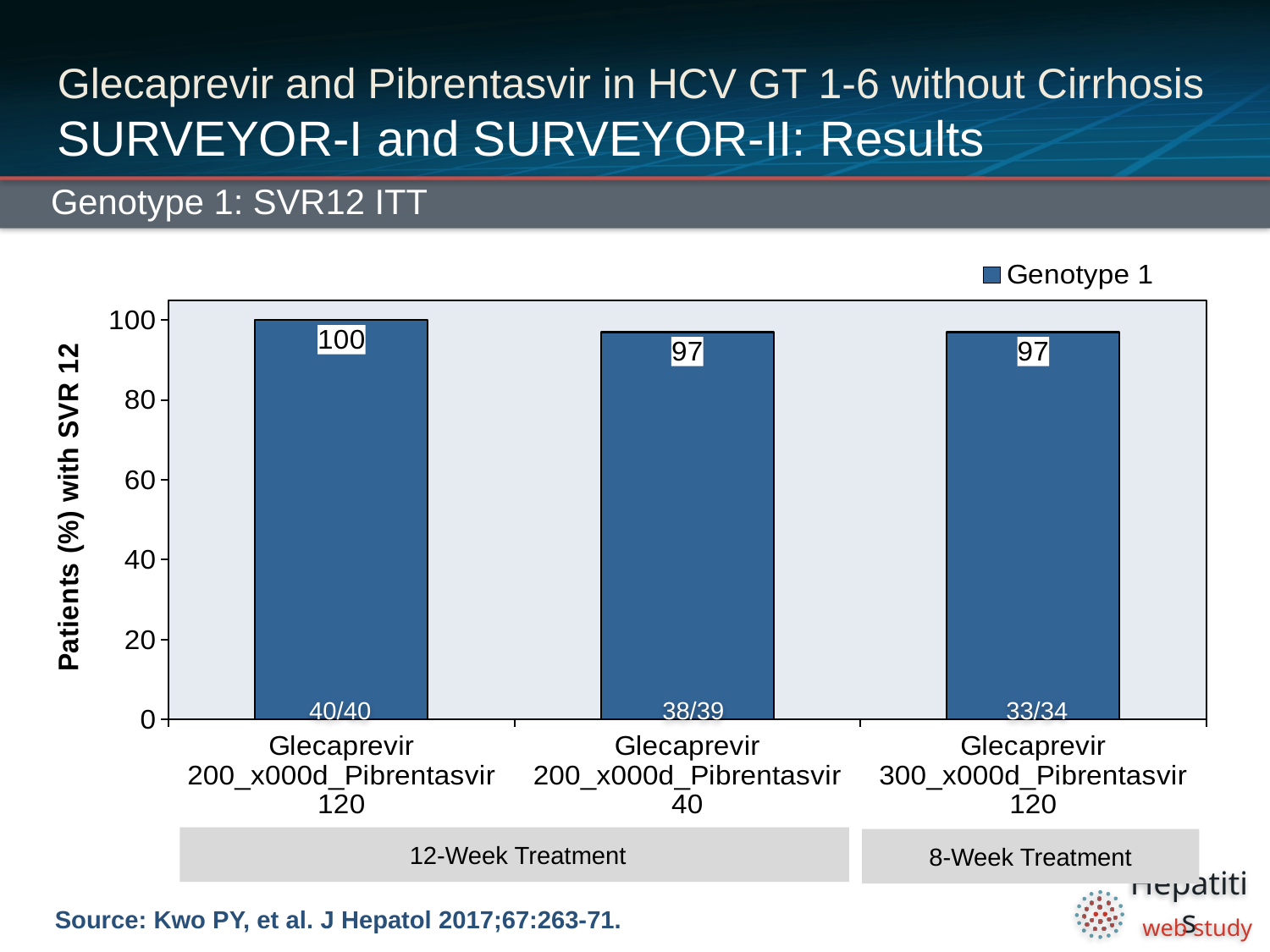
How many series does the legend list? 1 What type of chart is shown on the slide? bar chart What patient fraction is shown at the base of the Glecaprevir 200 / Pibrentasvir 40 bar? 38/39 What is the SVR12 value for the Glecaprevir 300 / Pibrentasvir 120 group in the 8-week treatment arm? 97 How many bars are plotted in the chart? 3 What is the SVR12 value for the Glecaprevir 200 / Pibrentasvir 40 group? 97 Is the SVR12 value for the Glecaprevir 300 / Pibrentasvir 120 group greater or less than 80? greater What is the SVR12 value for the Glecaprevir 200 / Pibrentasvir 120 group in the 12-week treatment arm? 100 Which group has the highest SVR12 value? Glecaprevir 200 / Pibrentasvir 120 (12-week) What is the difference between the SVR12 value for Glecaprevir 200 / Pibrentasvir 120 and Glecaprevir 200 / Pibrentasvir 40? 3 What patient fraction is shown at the base of the Glecaprevir 300 / Pibrentasvir 120 bar? 33/34 What is the label of the y axis? Patients (%) with SVR 12